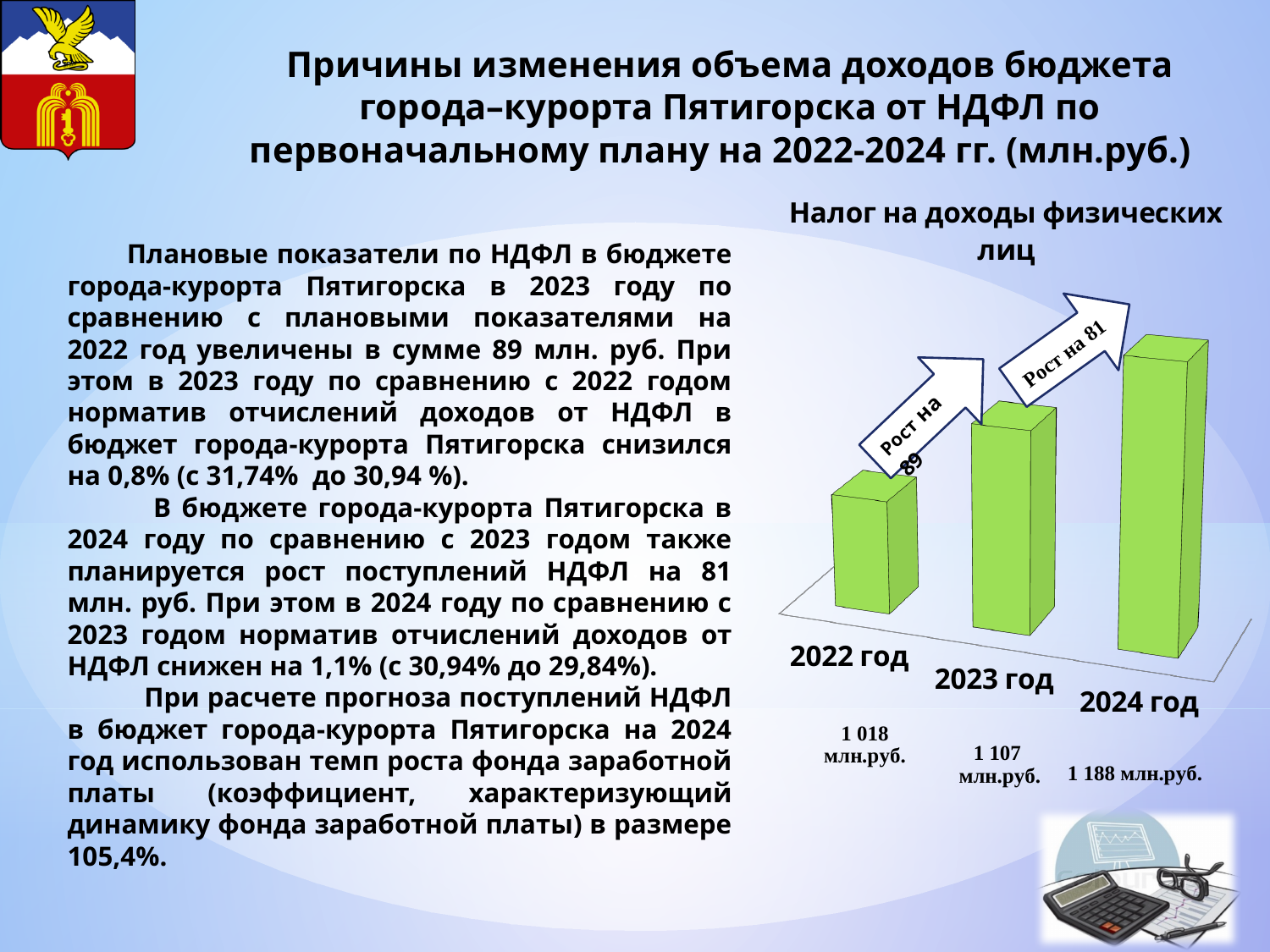
What type of chart is shown on the slide? Bar chart Which year has the lowest value in the chart? 2022 год What is the difference between the values for 2024 год and 2022 год? 170 млн.руб. By how much does the value for 2023 год exceed the value for 2022 год? 89 млн.руб. What is the value shown for 2022 год? 1 018 млн.руб. By how much does the value for 2024 год exceed the value for 2023 год? 81 млн.руб. Which is larger, the value for 2023 год or the value for 2024 год? 2024 год How many years (categories) are shown in the chart? 3 What is the value shown for 2024 год? 1 188 млн.руб. Which year has the highest value in the chart? 2024 год What is the value shown for 2023 год? 1 107 млн.руб. Do the values rise or fall from 2022 год to 2024 год? Rise